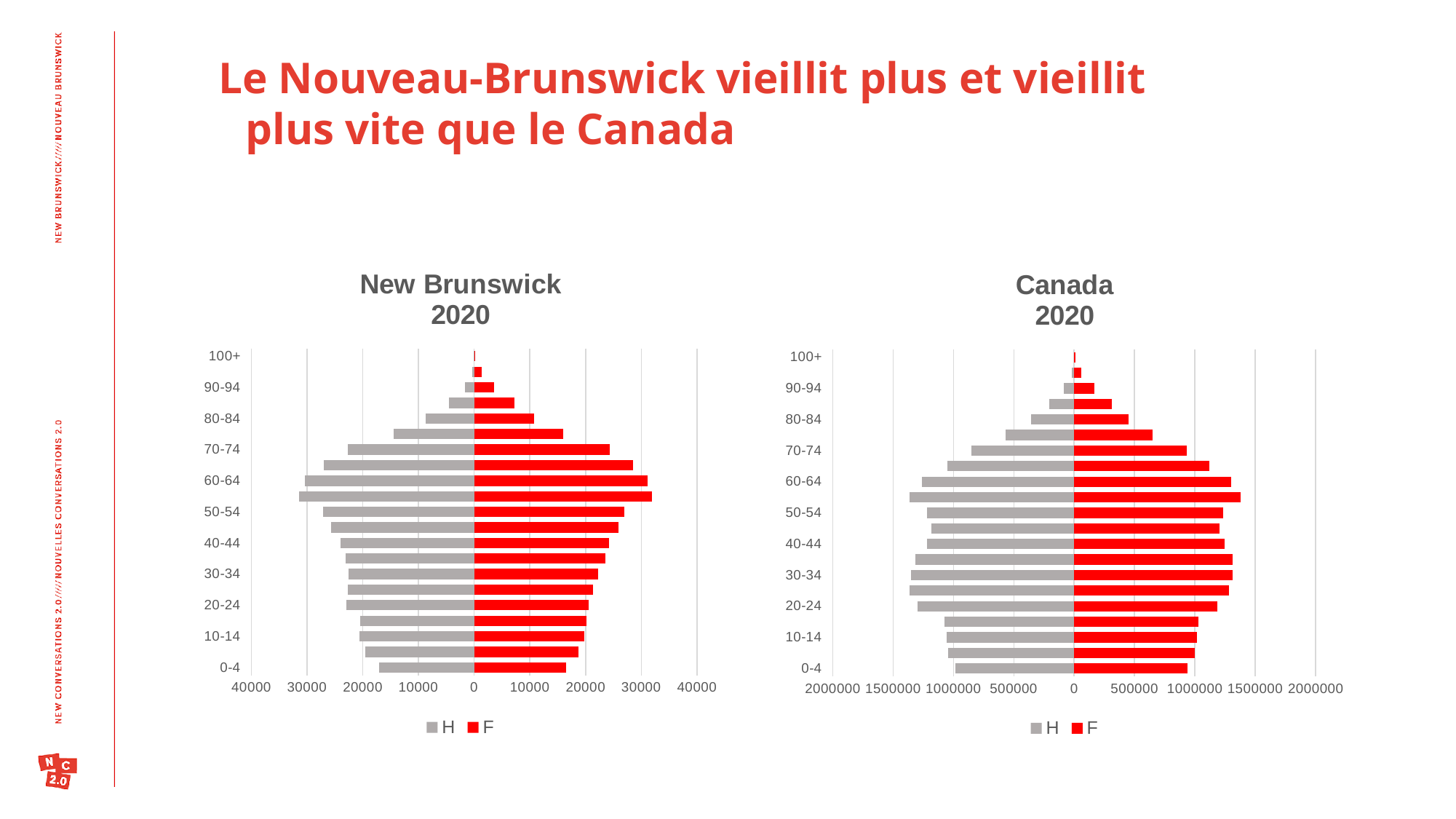
In the Canada 2020 chart, which labelled age group has the smallest bars? 100+ In the New Brunswick 2020 chart, which is larger for the F series: the 60-64 age group or the 0-4 age group? 60-64 In the Canada 2020 chart, is the H value for the 70-74 age group greater or less than 1000000? less What kind of chart is the New Brunswick 2020 chart? bar chart In the Canada 2020 chart, which colour represents the F series? red In the New Brunswick 2020 chart, is the F value for the 70-74 age group greater or less than 20000? greater In the New Brunswick 2020 chart, is the F value for the 0-4 age group greater or less than 20000? less In the Canada 2020 chart, which is larger for the F series: the 30-34 age group or the 70-74 age group? 30-34 In the New Brunswick 2020 chart, what are the two legend entries? H and F How many series does the legend of the Canada 2020 chart list? 2